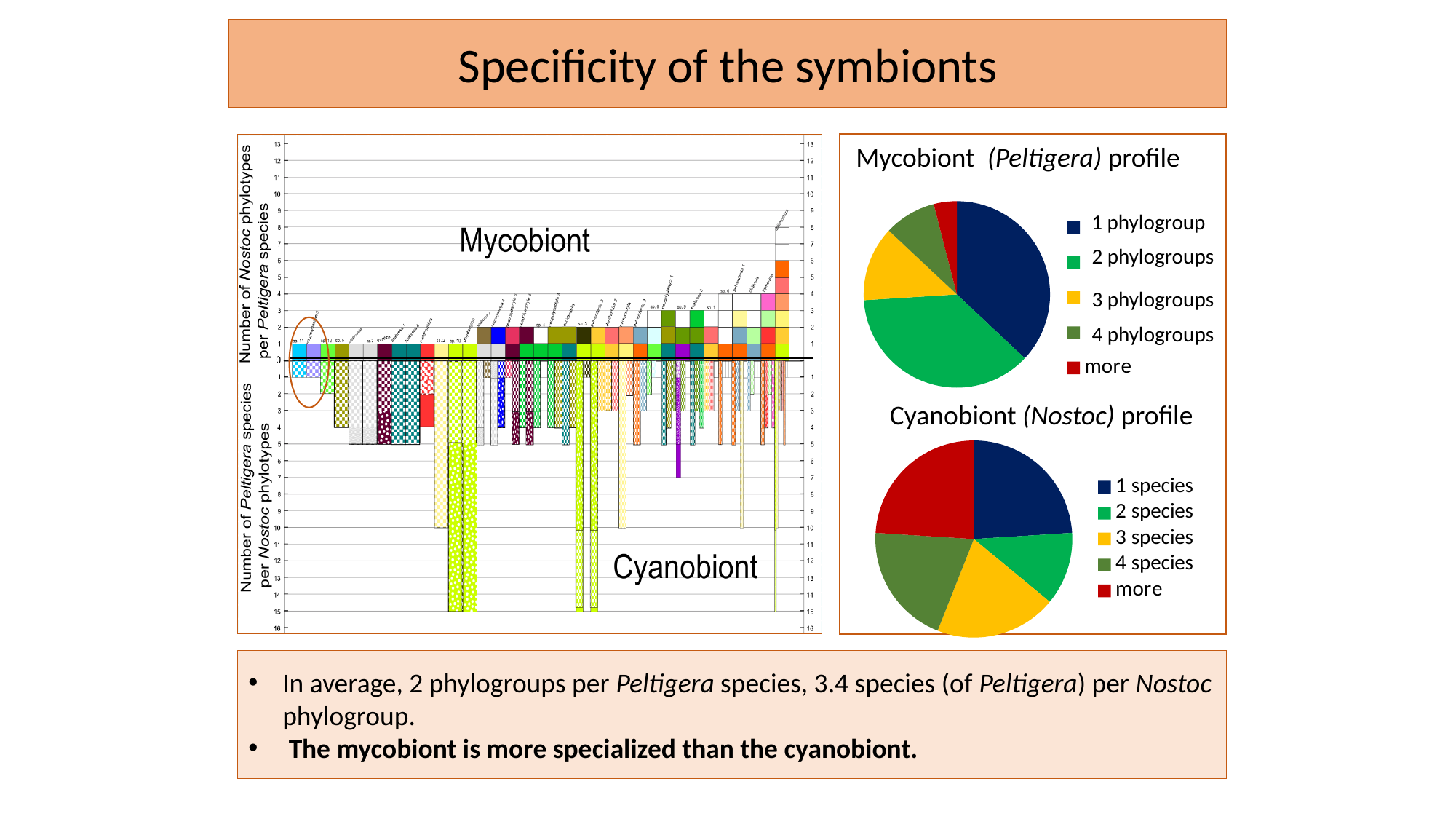
How many categories does the legend of the 'Mycobiont (Peltigera) profile' pie chart list? 5 In the 'Mycobiont (Peltigera) profile' pie chart, which category has the smallest slice? more What kind of chart is the large chart on the left of the slide labelled 'Mycobiont' and 'Cyanobiont'? bar chart What kind of chart is the 'Cyanobiont (Nostoc) profile' chart? pie chart What kind of chart is the 'Mycobiont (Peltigera) profile' chart? pie chart In the 'Mycobiont (Peltigera) profile' pie chart, what colour is the '1 phylogroup' slice? dark blue In the 'Cyanobiont (Nostoc) profile' pie chart, which slice is larger: '3 species' or '2 species'? 3 species In the 'Mycobiont (Peltigera) profile' pie chart, which slice is larger: '3 phylogroups' or 'more'? 3 phylogroups How many categories does the legend of the 'Cyanobiont (Nostoc) profile' pie chart list? 5 In the large chart on the left, what is the highest tick value shown on the upper (Mycobiont) vertical axis? 13 In the 'Cyanobiont (Nostoc) profile' pie chart, which category has the smallest slice? 2 species In the 'Cyanobiont (Nostoc) profile' pie chart, which slice is larger: '1 species' or '2 species'? 1 species